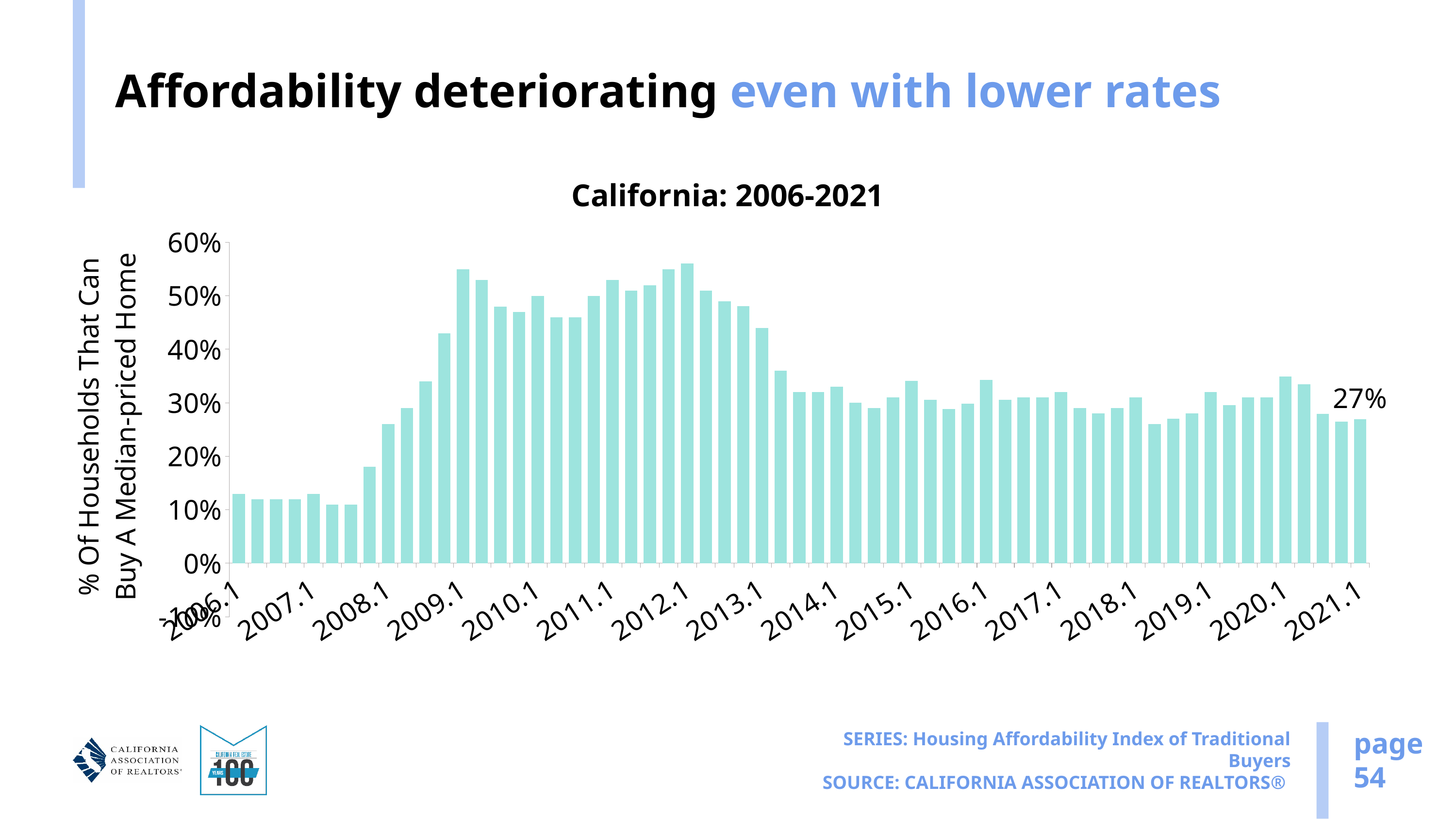
Is the value for 2006.1 greater or less than 20%? less What does the y axis measure? % Of Households That Can Buy A Median-priced Home Which is larger, the value for 2010.1 or the value for 2021.1? 2010.1 Which is larger, the value for 2012.1 or the value for 2006.1? 2012.1 Do the values rise or fall from 2006.1 to 2009.1? rise What kind of chart is shown on the slide? bar chart Is the value for 2012.1 greater or less than 50%? greater Is the value for 2010.1 greater or less than 40%? greater What is the title of the chart? California: 2006-2021 What is the value shown for the last bar, labelled 2021.1? 27%